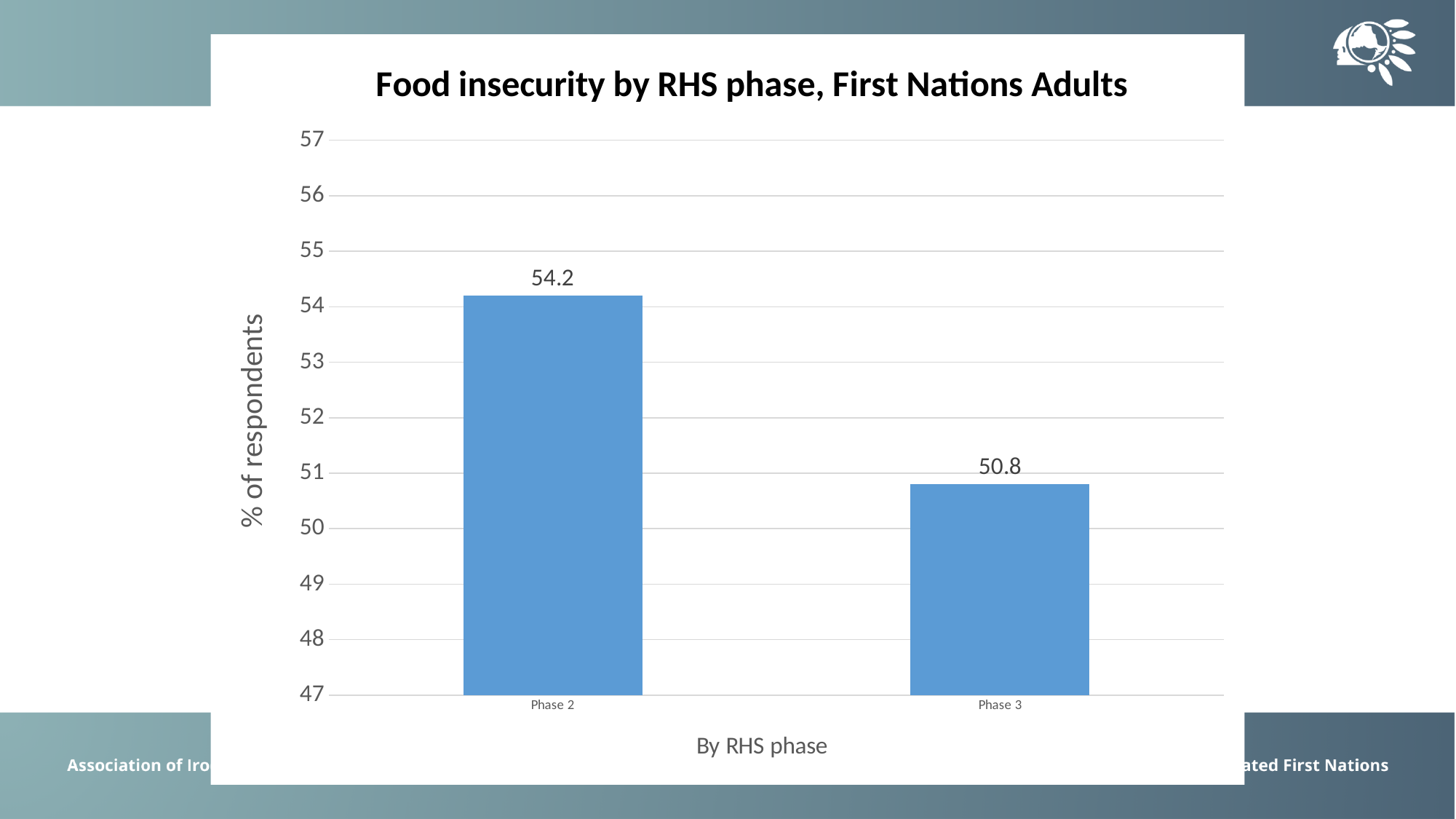
How many categories are shown on the x axis? 2 What is the value for Phase 2? 54.2 Which is larger, the value for Phase 2 or Phase 3? Phase 2 What is the difference between the values for Phase 2 and Phase 3? 3.4 Is the value for Phase 2 greater or less than 53? greater Which phase has the lowest value? Phase 3 What kind of chart is this? bar chart Do the values rise or fall from Phase 2 to Phase 3? fall What is the title of the chart? Food insecurity by RHS phase, First Nations Adults Is the value for Phase 3 greater or less than 52? less Which phase has the highest value? Phase 2 What is the value for Phase 3? 50.8